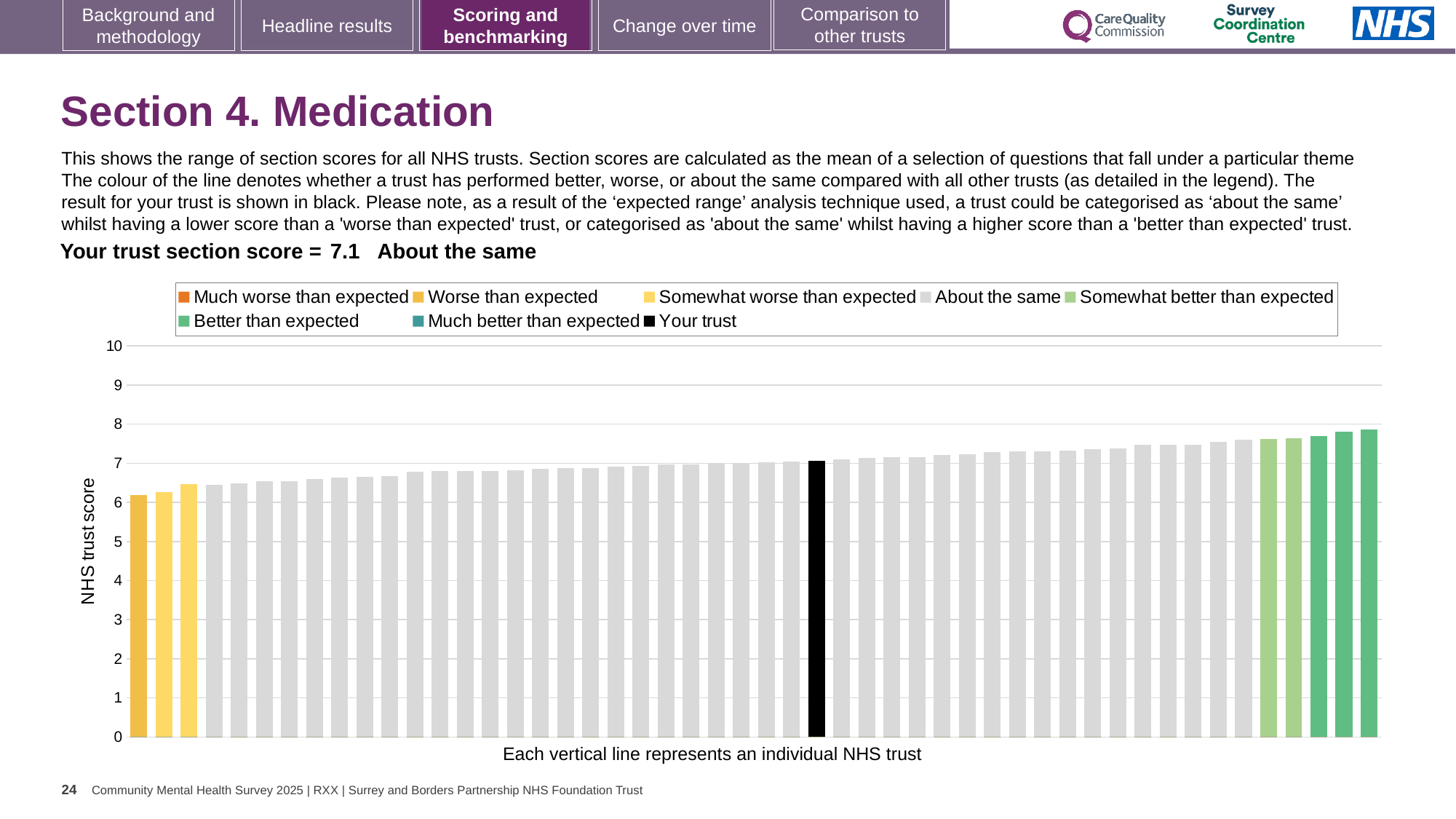
What is the section score for your trust (the black bar)? 7.1 What does each vertical line in the chart represent, according to the x-axis label? an individual NHS trust Which legend category does the tallest bar belong to? Better than expected Do the bar values rise or fall from left to right along the x axis? rise What kind of chart is shown on the slide? bar chart How many entries does the chart legend list? 8 Is the value of the leftmost (lowest) bar greater or less than 7? less Is the value of the rightmost (highest) bar greater or less than 8? less What is the label on the y axis of the chart? NHS trust score Is the value of the rightmost (highest) bar greater or less than 7? greater Which is larger, the value of the black bar for your trust or the value of the leftmost bar? the black bar for your trust